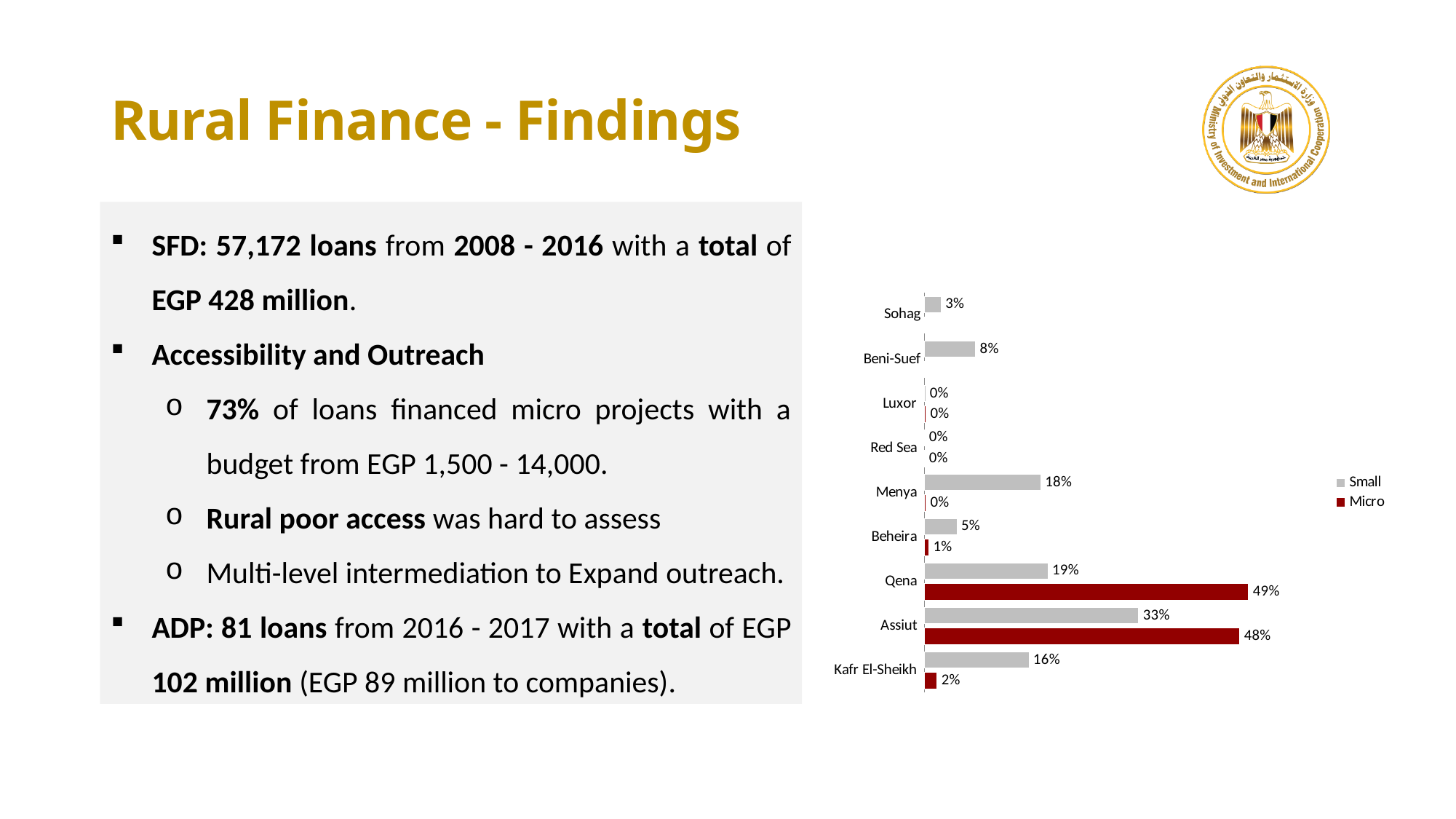
How many series does the chart's legend list? 2 What is the Small value for Assiut? 33% What colour represents the Micro series in the chart? Dark red What is the Micro value for Qena? 49% Which is larger, the Small value for Menya or the Small value for Kafr El-Sheikh? Menya Which governorate has the highest Small value? Assiut What is the Micro value for Beheira? 1% What is the Small value for Sohag? 3% How many governorates (categories) are shown in the chart? 9 What kind of chart is shown on the right of the slide? Bar chart What is the Micro value for Kafr El-Sheikh? 2% What is the difference between the Micro and Small values for Assiut? 15%